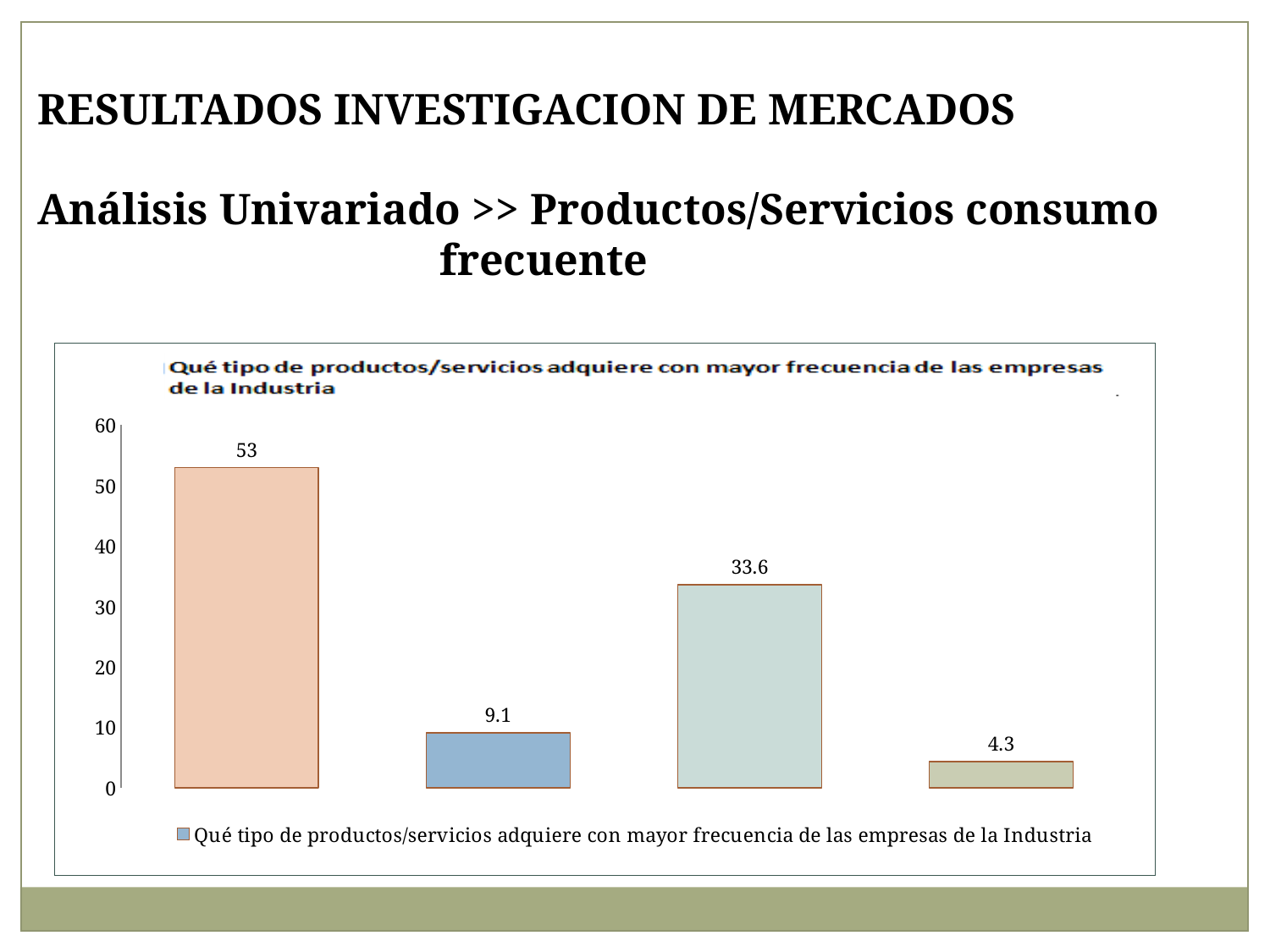
What is the value of the fourth (rightmost) bar in the chart? 4.3 What is the highest value shown in the chart? 53 What is the legend entry shown below the chart? Qué tipo de productos/servicios adquiere con mayor frecuencia de las empresas de la Industria Which is larger, the second bar from the left or the fourth bar from the left? the second bar (9.1) What is the value of the second bar from the left in the chart? 9.1 What type of chart is shown on the slide? bar chart What is the lowest value shown in the chart? 4.3 How many bars are plotted in the chart? 4 How many series does the legend list? 1 What is the difference between the first bar (53) and the third bar (33.6)? 19.4 What is the value of the first (leftmost) bar in the chart? 53 What is the value of the third bar from the left in the chart? 33.6